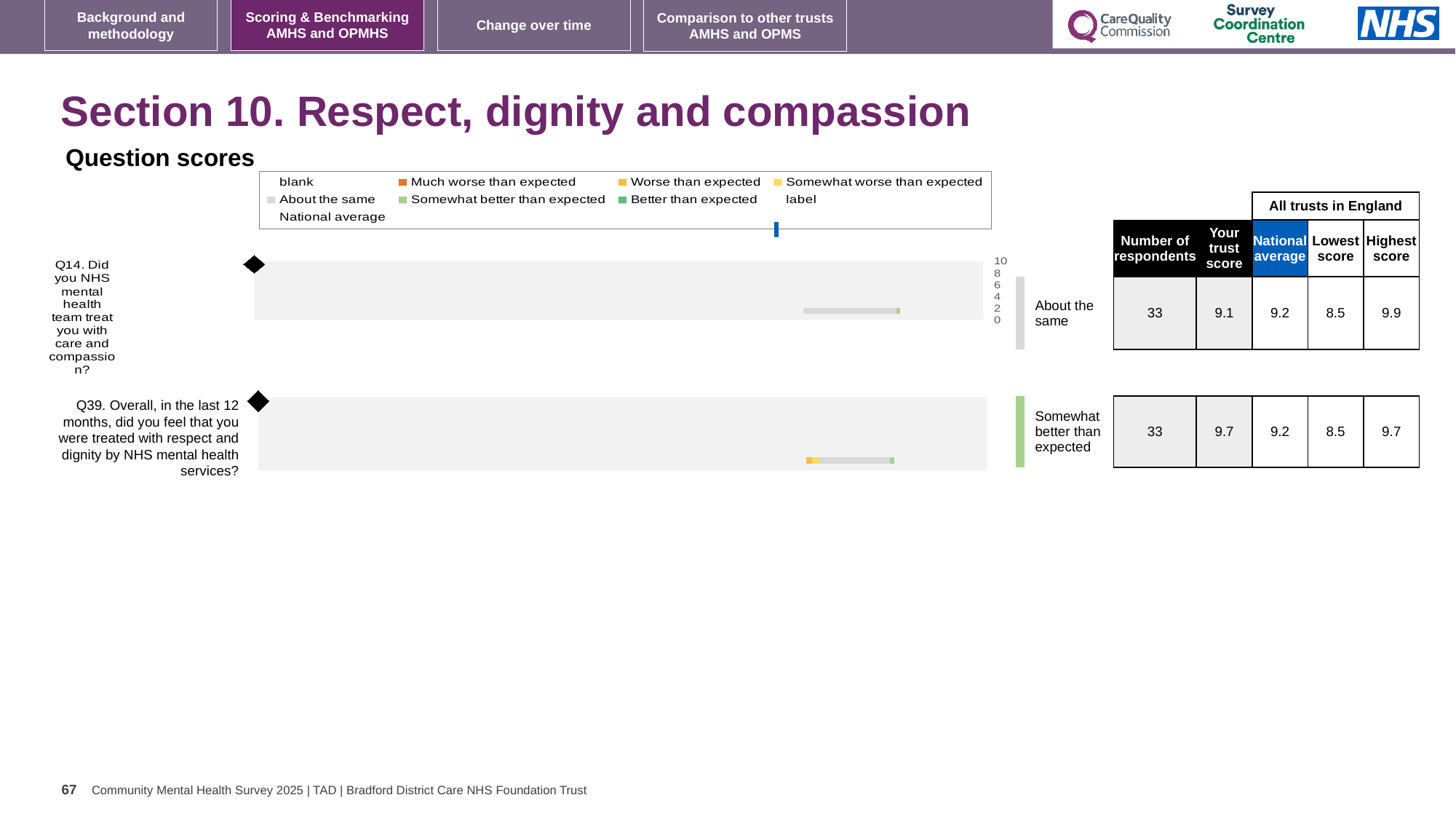
Which benchmark category label is shown next to the bar for Q14? About the same What is the highest score among all trusts in England shown for Q14? 9.9 What is the trust score shown for Q39 (respect and dignity)? 9.7 Which question has the higher trust score, Q14 or Q39? Q39 How many questions (categories) are plotted in the question scores chart? 2 What is the trust score shown for Q14 (care and compassion)? 9.1 What is the difference between the trust scores for Q39 and Q14? 0.6 What kind of chart is used to show the question scores on this slide? Bar chart What is the difference between the highest score and the trust score for Q14? 0.8 Which benchmark category label is shown next to the bar for Q39? Somewhat better than expected What is the national average shown for Q14? 9.2 What is the number of respondents shown for Q39? 33